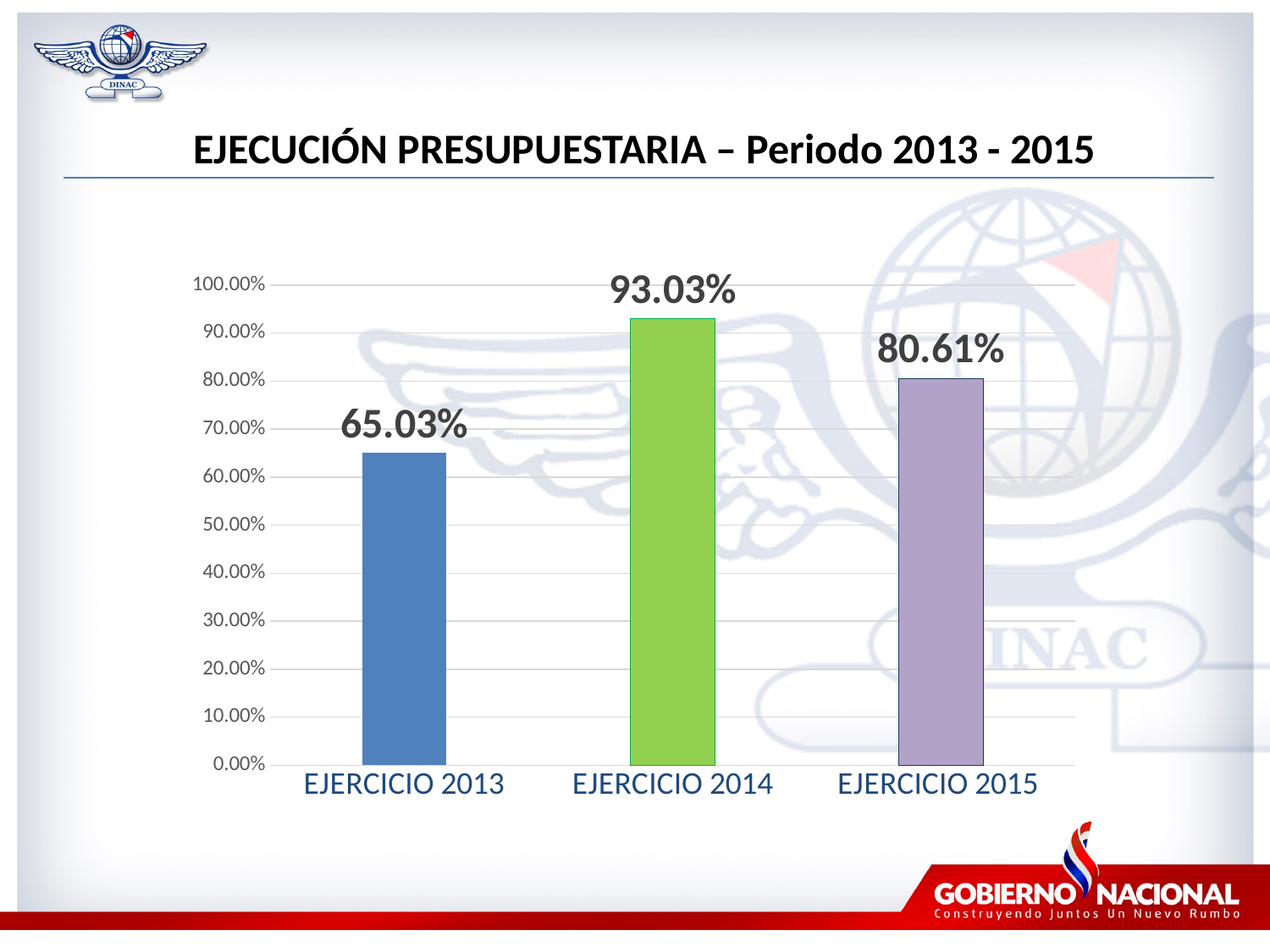
Which category has the highest value? EJERCICIO 2014 What is the value for EJERCICIO 2013? 65.03% Is the value for EJERCICIO 2015 greater or less than 90.00%? less Which is larger, the value for EJERCICIO 2015 or the value for EJERCICIO 2013? EJERCICIO 2015 What is the difference between the values for EJERCICIO 2014 and EJERCICIO 2015? 12.42% What is the value for EJERCICIO 2014? 93.03% What is the title of the slide containing the chart? EJECUCIÓN PRESUPUESTARIA – Periodo 2013 - 2015 How many categories are shown on the x axis? 3 What is the value for EJERCICIO 2015? 80.61% What kind of chart is shown on the slide? bar chart What is the difference between the values for EJERCICIO 2014 and EJERCICIO 2013? 28.00% Which category has the lowest value? EJERCICIO 2013